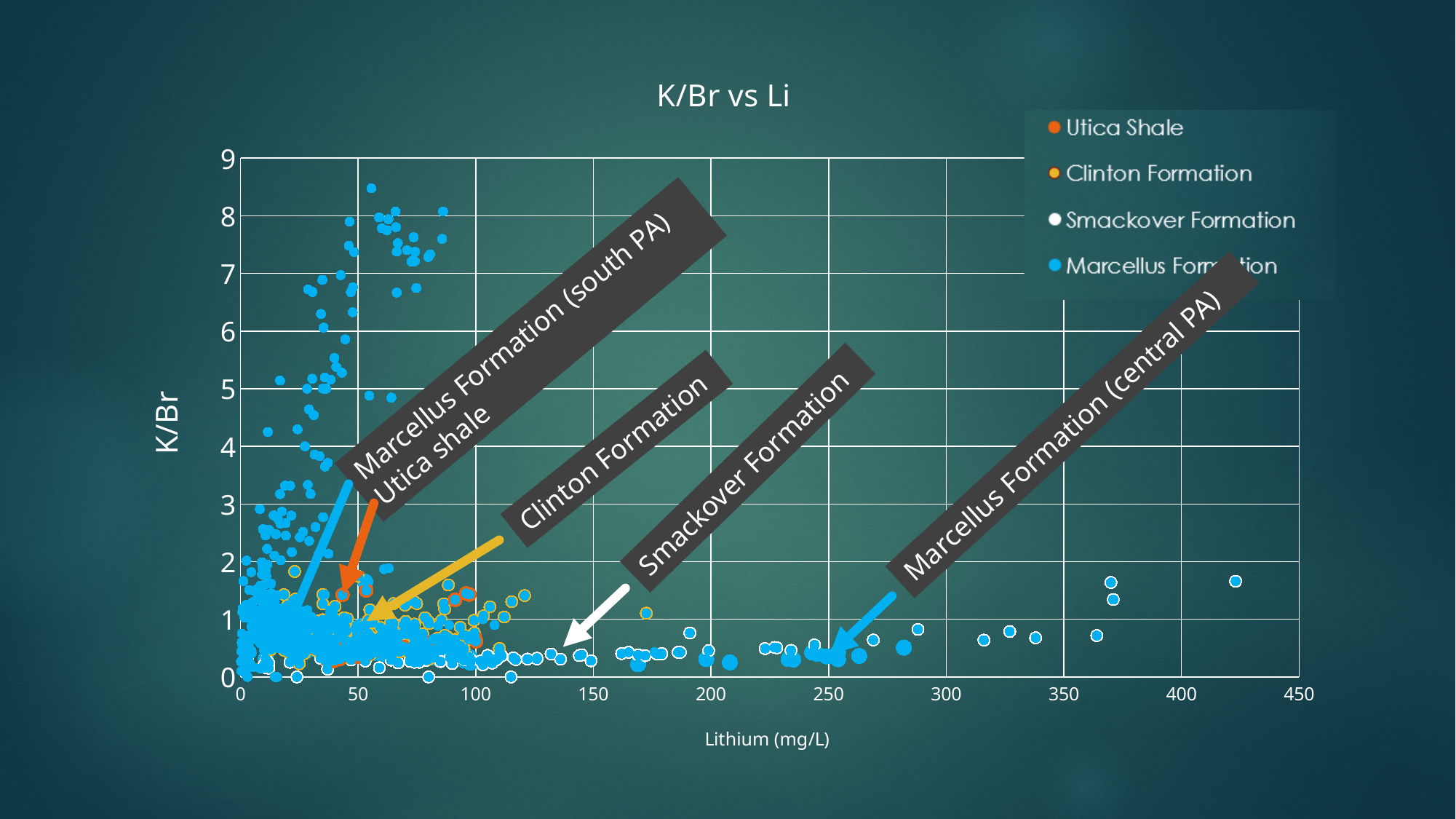
Which series has points plotted at lithium values above 400 mg/L? Marcellus Formation Is the highest K/Br value plotted for the Clinton Formation greater or less than 3? less How many series does the legend list? 4 What is the label of the x axis? Lithium (mg/L) Is the lithium value of the rightmost plotted point greater or less than 400? greater What is the title of the chart? K/Br vs Li Is the highest K/Br value plotted for the Marcellus Formation greater or less than 8? greater What kind of chart is shown on the slide? Scatter chart What is the highest value shown on the y axis (K/Br)? 9 What is the highest value shown on the x axis (Lithium)? 450 Which series reaches the highest K/Br values on the chart? Marcellus Formation